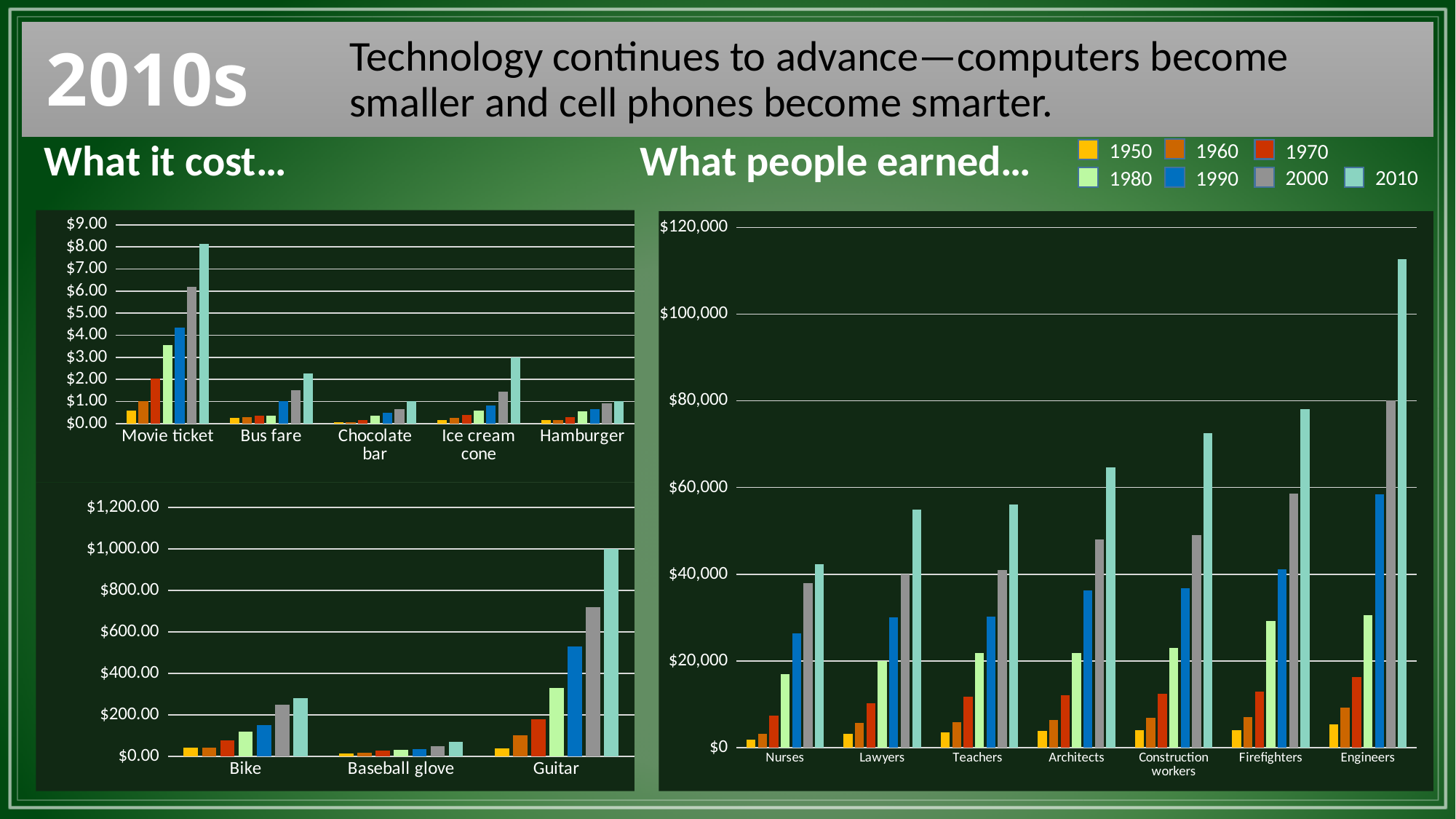
On the 'What people earned...' chart, which is larger: the 2010 value for Architects or the 2010 value for Lawyers? Architects On the 'What people earned...' chart, which occupation has the highest 2010 value? Engineers On the 'What people earned...' chart, is the 2010 value for Engineers greater or less than $100,000? greater On the top-left 'What it cost...' chart, which item has the highest 2010 value? Movie ticket On the 'What people earned...' chart, which occupation has the lowest 2010 value? Nurses On the bottom-left 'What it cost...' chart, how many items are shown on the x axis? 3 On the bottom-left 'What it cost...' chart, is the 2010 value for Guitar greater or less than $800.00? greater How many occupations are shown on the 'What people earned...' chart? 7 On the top-left 'What it cost...' chart, is the 2010 value for Movie ticket greater or less than $7.00? greater What kind of chart is the 'What people earned...' chart? bar chart How many series does the legend list for the charts on this slide? 7